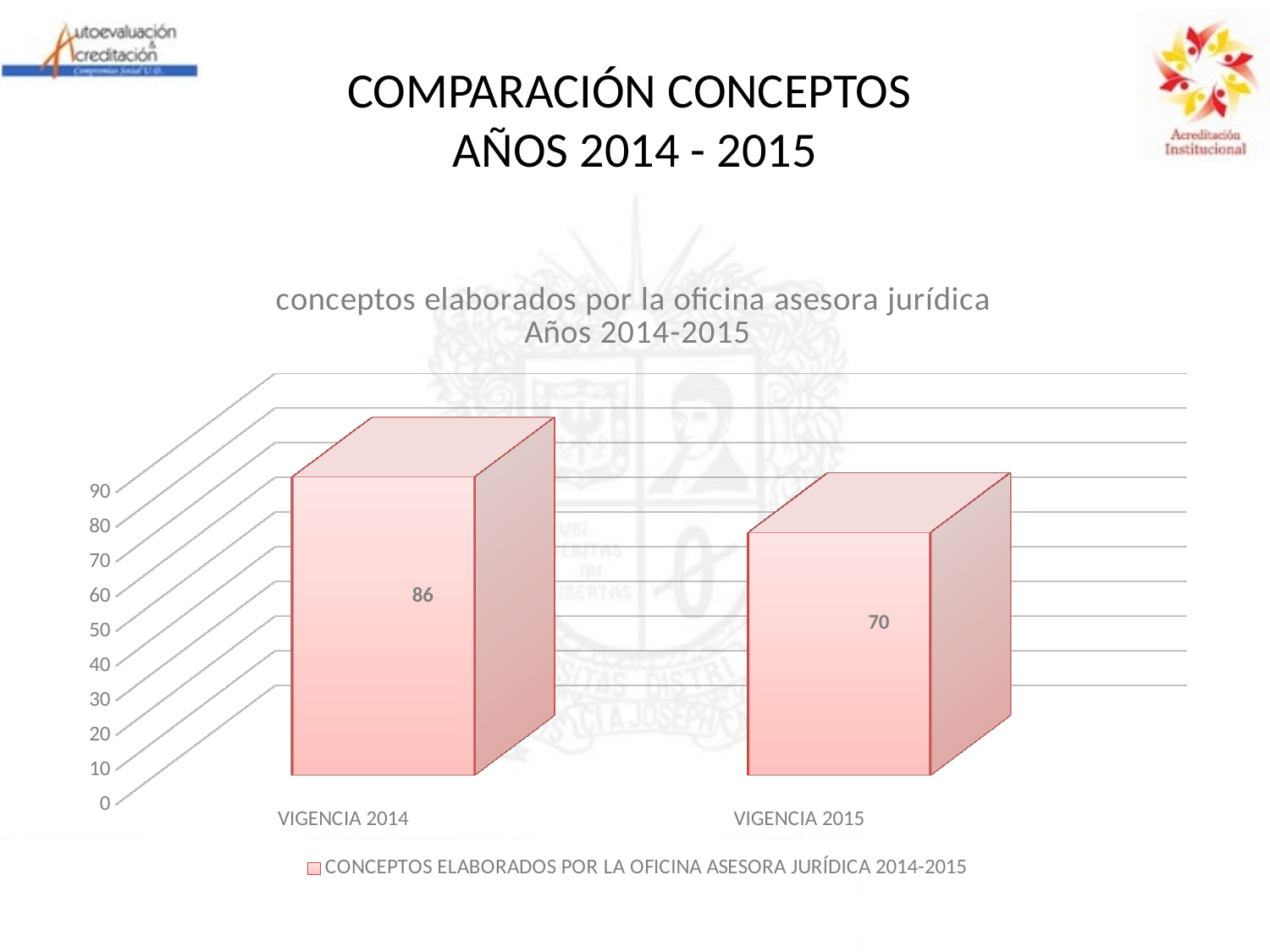
What is the difference between the values for VIGENCIA 2014 and VIGENCIA 2015? 16 What is the value for VIGENCIA 2015? 70 What kind of chart is shown on the slide? bar chart What is the value for VIGENCIA 2014? 86 Which category has the highest value? VIGENCIA 2014 How many series does the legend list? 1 Which is larger, the value for VIGENCIA 2014 or VIGENCIA 2015? VIGENCIA 2014 How many categories are shown on the x axis? 2 Is the value for VIGENCIA 2015 greater or less than 80? less Do the values rise or fall from VIGENCIA 2014 to VIGENCIA 2015? fall Which category has the lowest value? VIGENCIA 2015 What is the legend entry of the series shown in the chart? CONCEPTOS ELABORADOS POR LA OFICINA ASESORA JURÍDICA 2014-2015